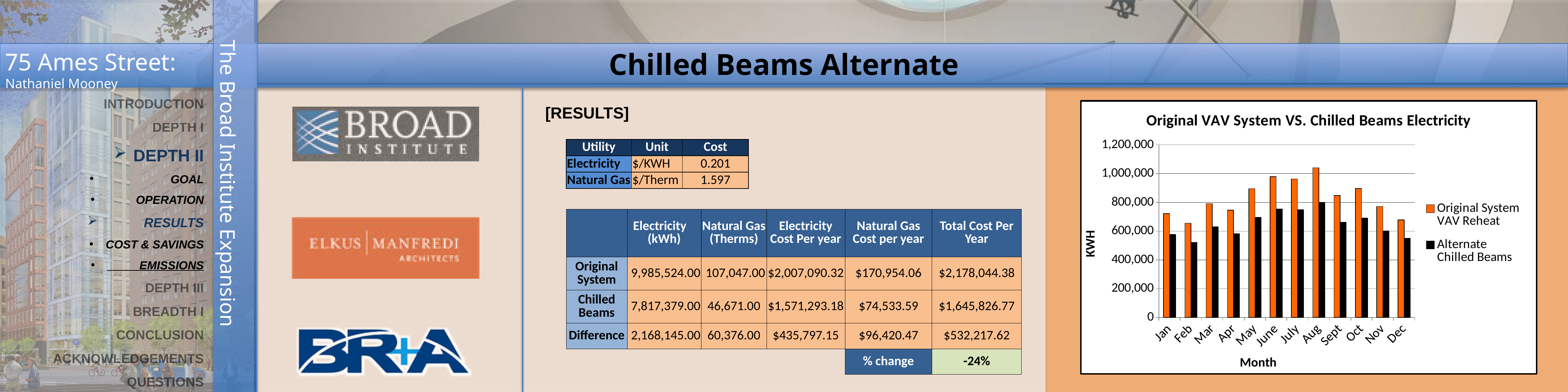
In which month is the Alternate Chilled Beams electricity highest? Aug How many months are plotted along the x axis of the chart? 12 From Aug to Dec, do the Alternate Chilled Beams values generally rise or fall? fall Is the Original System VAV Reheat value for Aug greater or less than 1,000,000 KWH? greater Is the Alternate Chilled Beams value for Aug greater or less than 600,000 KWH? greater Is the Alternate Chilled Beams value for Feb greater or less than 600,000 KWH? less What is the title of the chart? Original VAV System VS. Chilled Beams Electricity How many series does the legend of the chart list? 2 What kind of chart is shown on the slide? Bar chart In June, which series has the larger value: Original System VAV Reheat or Alternate Chilled Beams? Original System VAV Reheat In which month is the Original System VAV Reheat electricity highest? Aug